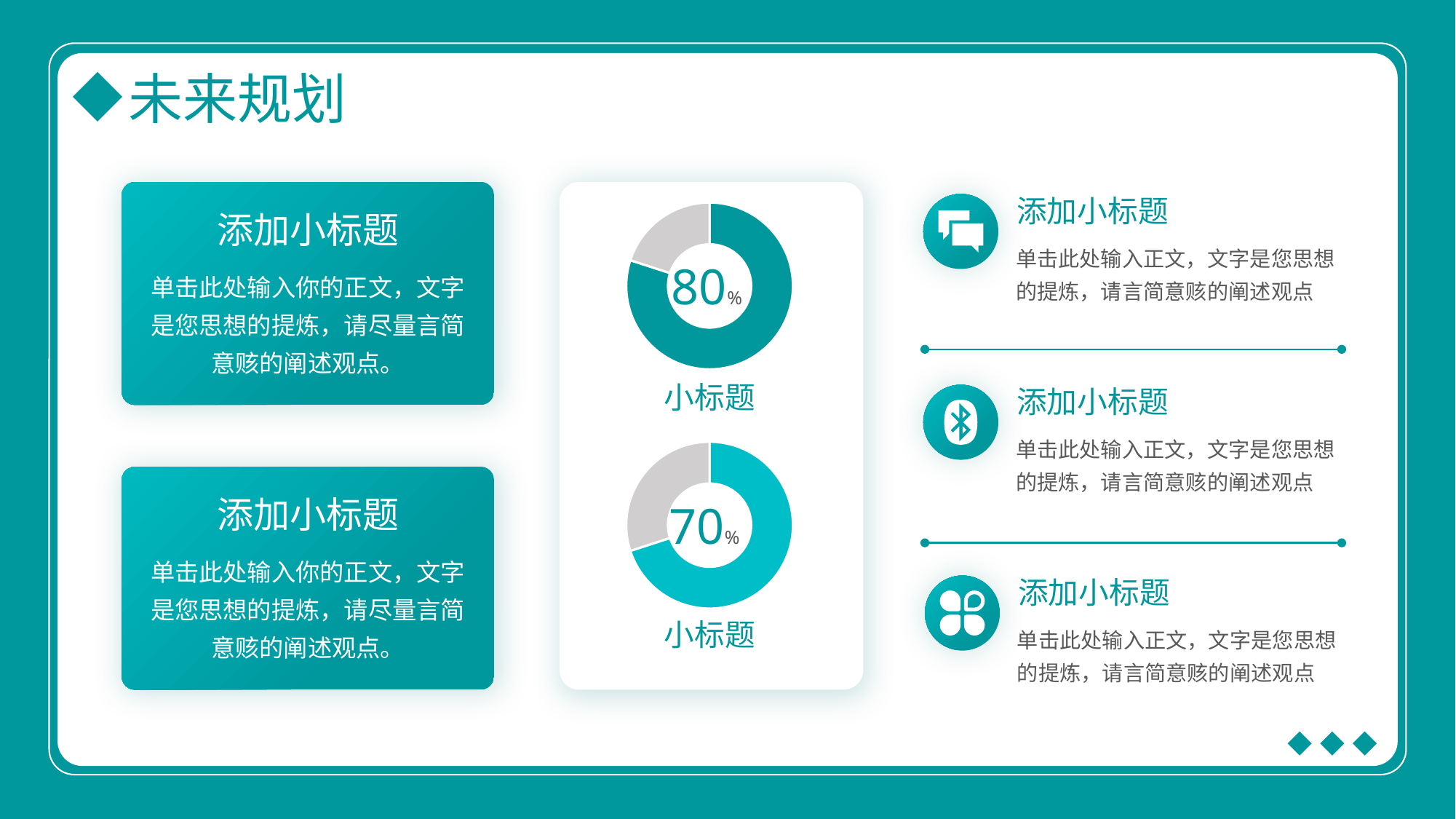
What kind of chart is the top chart in the middle panel? Donut (pie) chart In the top donut chart, what share of the ring is the grey (unfilled) portion? 20% Which of the two donut charts shows the larger value, the top one or the bottom one? The top one What value is shown in the centre of the bottom donut chart? 70% What is the label printed below each donut chart? 小标题 How many donut charts are shown on the slide? 2 Is the value shown in the bottom donut chart greater or less than 50%? greater In the bottom donut chart, what share of the ring is the grey (unfilled) portion? 30% What value is shown in the centre of the top donut chart? 80% What is the difference between the value in the top donut chart and the value in the bottom donut chart? 10 percentage points Is the value shown in the top donut chart greater or less than 90%? less What colour is the filled portion of the bottom donut chart? Light teal (cyan)